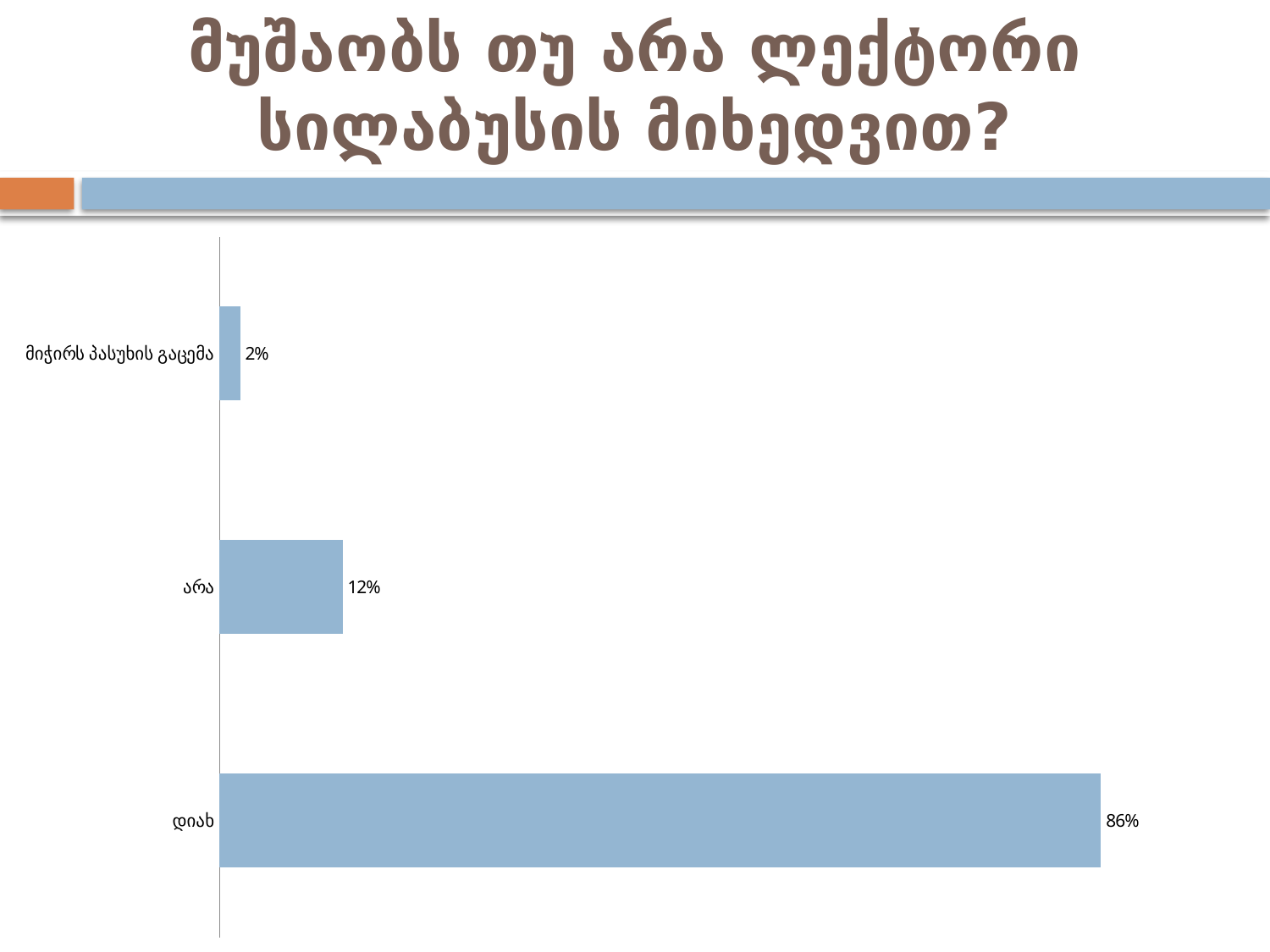
What is the difference between the values for არა and მიჭირს პასუხის გაცემა? 10% What is the title of the slide? მუშაობს თუ არა ლექტორი სილაბუსის მიხედვით? What is the value for დიახ? 86% Which category has the highest value? დიახ What is the value for მიჭირს პასუხის გაცემა? 2% What colour are the bars in the chart? light blue Which category has the lowest value? მიჭირს პასუხის გაცემა What kind of chart is shown on the slide? bar chart What is the difference between the values for დიახ and არა? 74% Which is larger, the value for არა or the value for მიჭირს პასუხის გაცემა? არა What is the value for არა? 12% How many categories are shown in the chart? 3